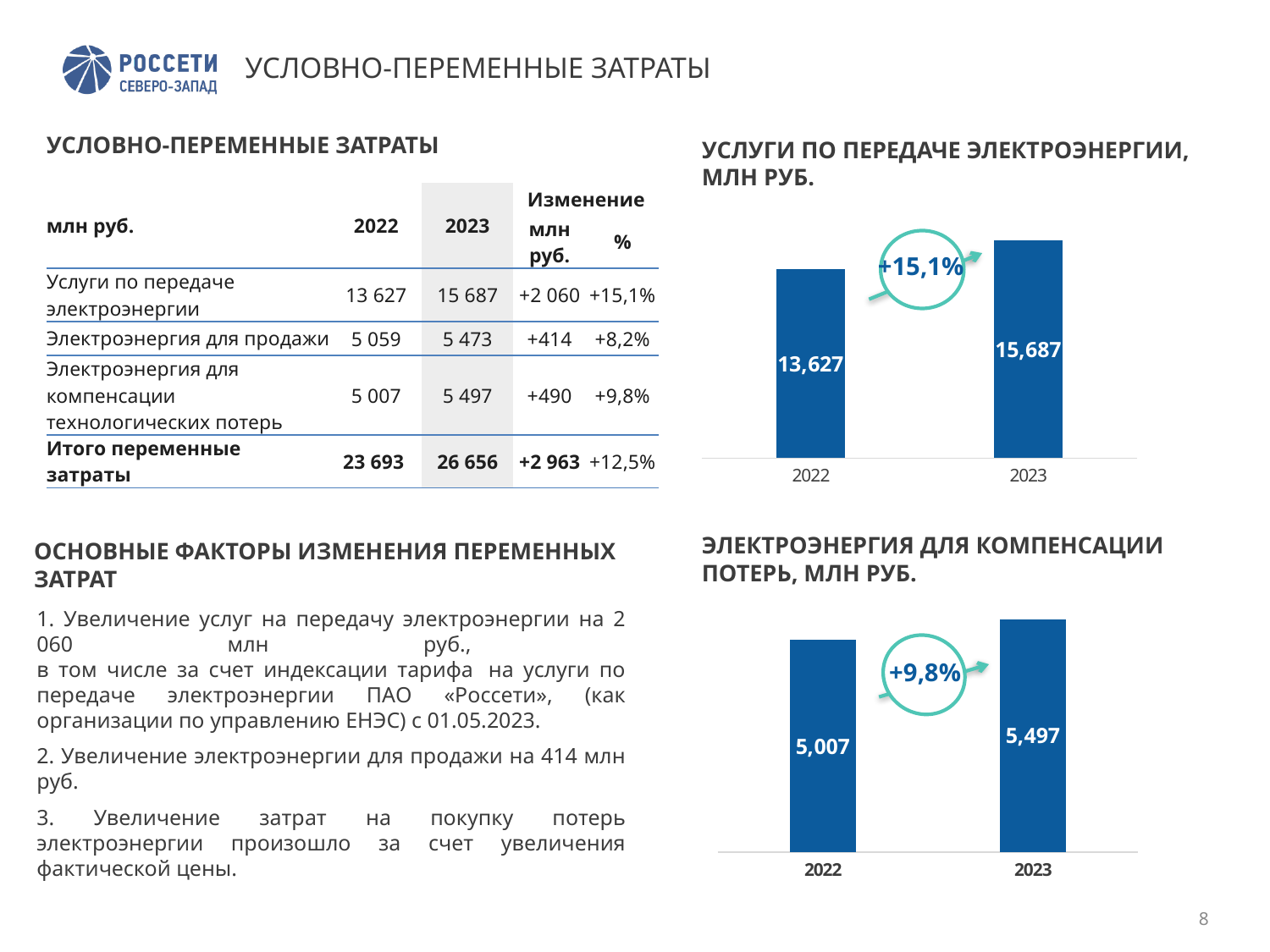
In the chart titled 'УСЛУГИ ПО ПЕРЕДАЧЕ ЭЛЕКТРОЭНЕРГИИ, МЛН РУБ.', which year has the higher value? 2023 In the chart titled 'УСЛУГИ ПО ПЕРЕДАЧЕ ЭЛЕКТРОЭНЕРГИИ, МЛН РУБ.', what is the difference between the 2023 and 2022 values? 2,060 In the chart titled 'ЭЛЕКТРОЭНЕРГИЯ ДЛЯ КОМПЕНСАЦИИ ПОТЕРЬ, МЛН РУБ.', what is the value for 2022? 5,007 In the chart titled 'УСЛУГИ ПО ПЕРЕДАЧЕ ЭЛЕКТРОЭНЕРГИИ, МЛН РУБ.', what is the value for 2023? 15,687 In the chart titled 'ЭЛЕКТРОЭНЕРГИЯ ДЛЯ КОМПЕНСАЦИИ ПОТЕРЬ, МЛН РУБ.', which year has the lower value? 2022 In the chart titled 'УСЛУГИ ПО ПЕРЕДАЧЕ ЭЛЕКТРОЭНЕРГИИ, МЛН РУБ.', how many bars are plotted? 2 In the chart titled 'ЭЛЕКТРОЭНЕРГИЯ ДЛЯ КОМПЕНСАЦИИ ПОТЕРЬ, МЛН РУБ.', what percentage change is shown between 2022 and 2023? +9,8% In the chart titled 'ЭЛЕКТРОЭНЕРГИЯ ДЛЯ КОМПЕНСАЦИИ ПОТЕРЬ, МЛН РУБ.', what is the difference between the 2023 and 2022 values? 490 In the chart titled 'УСЛУГИ ПО ПЕРЕДАЧЕ ЭЛЕКТРОЭНЕРГИИ, МЛН РУБ.', what is the value for 2022? 13,627 What kind of chart is the one titled 'ЭЛЕКТРОЭНЕРГИЯ ДЛЯ КОМПЕНСАЦИИ ПОТЕРЬ, МЛН РУБ.'? Bar chart In the chart titled 'ЭЛЕКТРОЭНЕРГИЯ ДЛЯ КОМПЕНСАЦИИ ПОТЕРЬ, МЛН РУБ.', what is the value for 2023? 5,497 In the chart titled 'УСЛУГИ ПО ПЕРЕДАЧЕ ЭЛЕКТРОЭНЕРГИИ, МЛН РУБ.', what percentage change is shown between 2022 and 2023? +15,1%